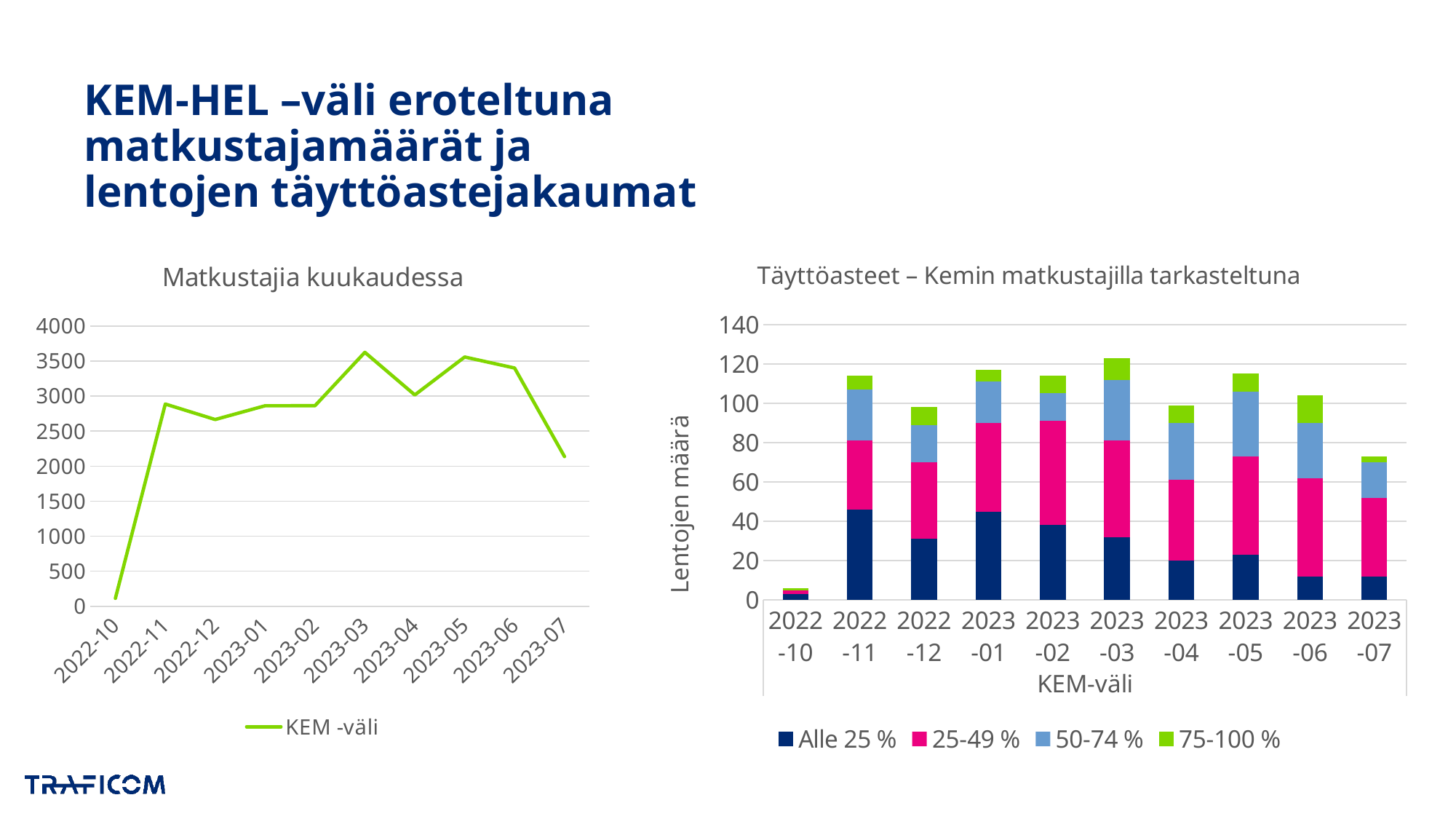
What type of chart is the right chart titled 'Täyttöasteet – Kemin matkustajilla tarkasteltuna'? Stacked bar chart In the left chart 'Matkustajia kuukaudessa', how many months are plotted on the x axis? 10 In the right chart 'Täyttöasteet – Kemin matkustajilla tarkasteltuna', how many series does the legend list? 4 In the left chart 'Matkustajia kuukaudessa', which month has the lowest number of passengers? 2022-10 In the left chart 'Matkustajia kuukaudessa', is the value for 2023-07 greater or less than 2000? greater In the left chart 'Matkustajia kuukaudessa', is the value for 2022-10 greater or less than 500? less In the right chart 'Täyttöasteet – Kemin matkustajilla tarkasteltuna', is the total bar height for 2023-07 greater or less than 80? less In the right chart 'Täyttöasteet – Kemin matkustajilla tarkasteltuna', which month has the tallest stacked bar? 2023-03 In the right chart 'Täyttöasteet – Kemin matkustajilla tarkasteltuna', which month has the shortest stacked bar? 2022-10 What type of chart is the left chart titled 'Matkustajia kuukaudessa'? Line chart In the right chart 'Täyttöasteet – Kemin matkustajilla tarkasteltuna', which series is shown in green in the legend? 75-100 %